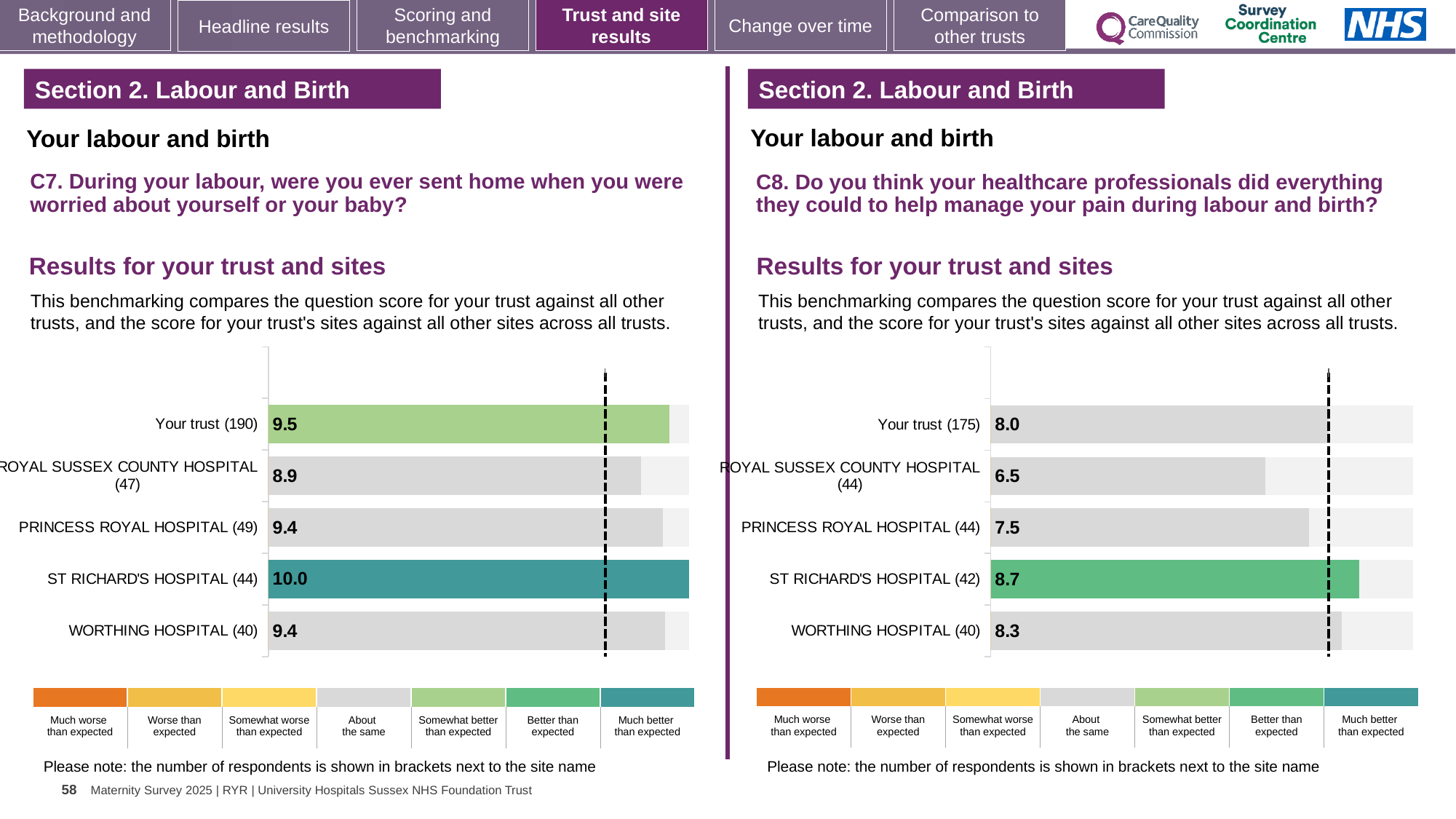
In the C7 chart on the left, what is the difference between the scores for ST RICHARD'S HOSPITAL (44) and ROYAL SUSSEX COUNTY HOSPITAL (47)? 1.1 In the C8 chart on the right, which site has the highest score? ST RICHARD'S HOSPITAL (42) In the C8 chart on the right, what is the score for ROYAL SUSSEX COUNTY HOSPITAL (44)? 6.5 In the C8 chart on the right, which is larger: the score for PRINCESS ROYAL HOSPITAL (44) or WORTHING HOSPITAL (40)? WORTHING HOSPITAL (40) In the C7 chart on the left, which benchmark category does the colour of the ST RICHARD'S HOSPITAL (44) bar correspond to? Much better than expected How many bars are shown in the C7 chart on the left? 5 In the C7 chart on the left, which site has the lowest score? ROYAL SUSSEX COUNTY HOSPITAL (47) In the C8 chart on the right, what is the difference between the scores for Your trust (175) and ROYAL SUSSEX COUNTY HOSPITAL (44)? 1.5 In the C7 chart on the left, what is the score for Your trust (190)? 9.5 In the C7 chart on the left, what is the score for ST RICHARD'S HOSPITAL (44)? 10.0 What type of chart is used in the C8 chart on the right? Bar chart In the C8 chart on the right, what is the score for WORTHING HOSPITAL (40)? 8.3